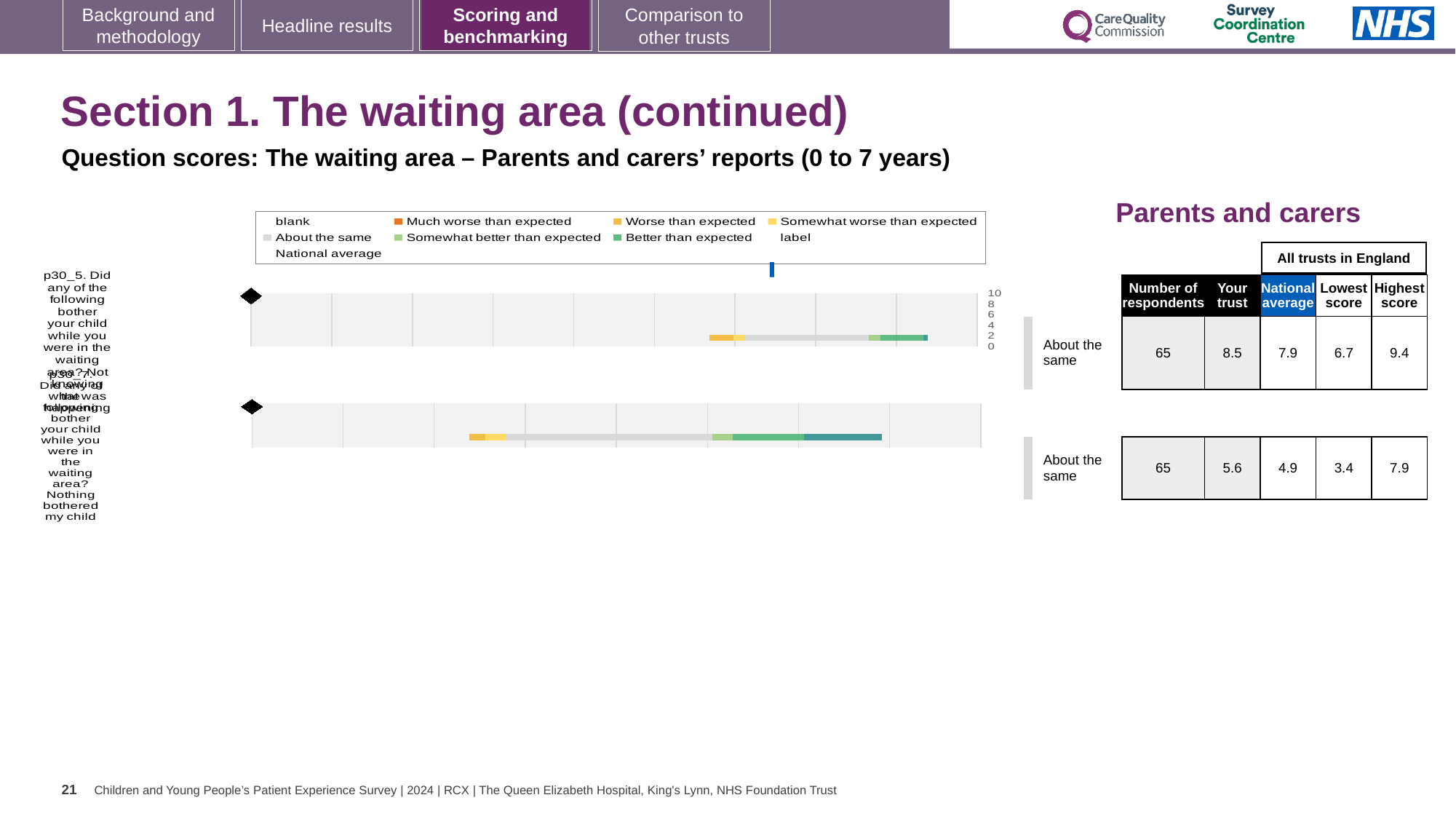
What is the maximum value shown on the chart's score axis? 10 What kind of chart is used to show the question scores on this slide? bar chart What is the difference between the 'Your trust' scores for p30_5 and p30_7? 2.9 What is the difference between the highest and lowest scores across all trusts in England for question p30_5? 2.7 What is the national average score for question p30_5? 7.9 What is the 'Your trust' score for question p30_7 (Did any of the following bother your child while you were in the waiting area? Nothing bothered my child)? 5.6 What is the 'Your trust' score for question p30_5 (Did any of the following bother your child while you were in the waiting area? Not knowing what was happening)? 8.5 What is the benchmark category shown for question p30_7? About the same How many respondents answered question p30_5? 65 Which question has the higher 'Your trust' score, p30_5 or p30_7? p30_5 How many questions (bars) are plotted in the chart? 2 What is the lowest score among all trusts in England for question p30_7? 3.4